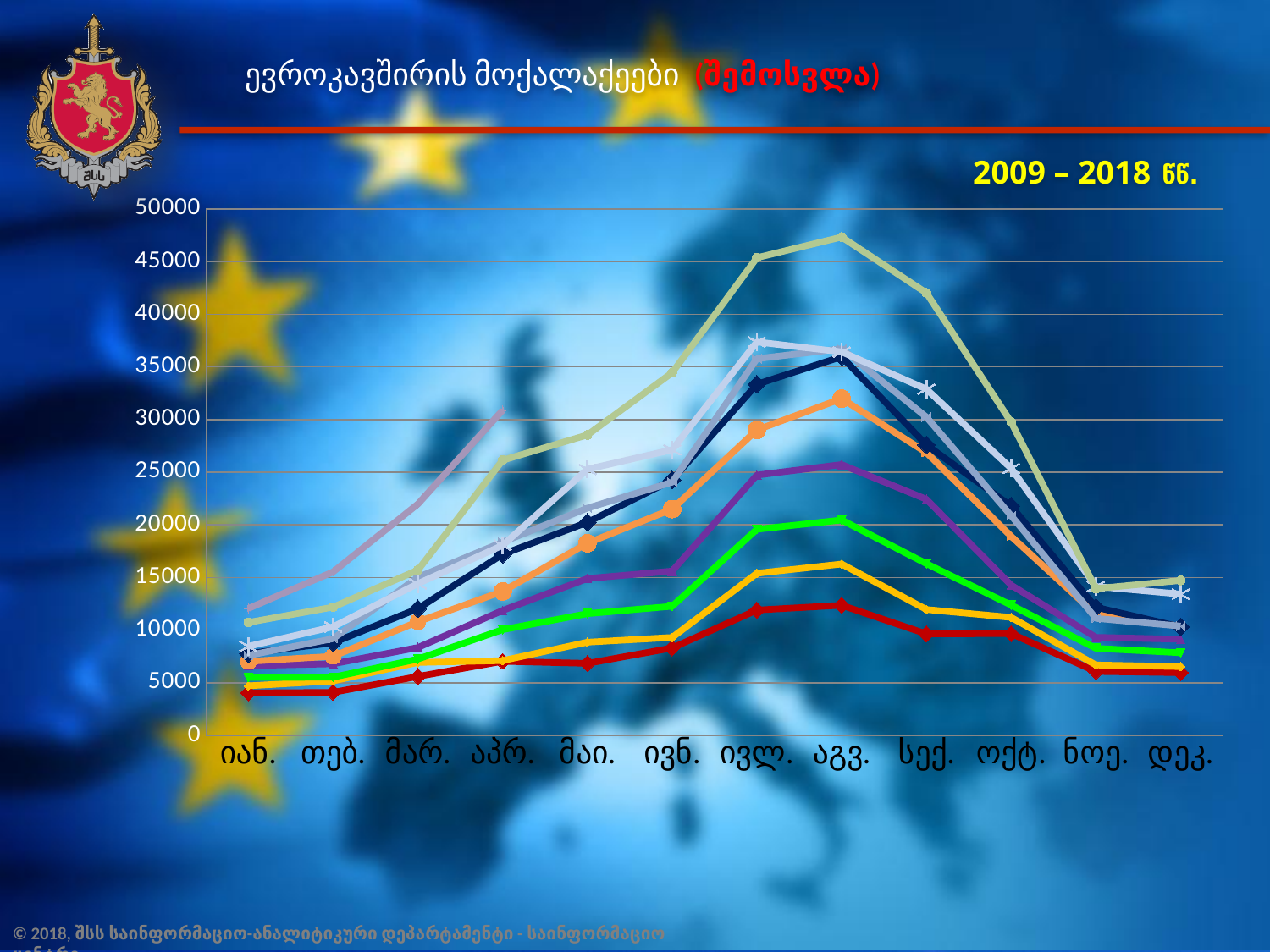
Which years does the chart cover, according to the label above it? 2009 – 2018 In which month does the topmost (pale yellow-green) line reach its highest value? აგვ. In აგვ., which line has the larger value: the red line or the pale yellow-green line? the pale yellow-green line What kind of chart is shown on the slide? line chart Is the value of the pale yellow-green line in აგვ. greater or less than 45000? greater How many months are shown along the x axis of the chart? 12 Is the value of the purple line in აგვ. greater or less than 20000? greater Does the pale yellow-green line rise or fall from აგვ. to ნოე.? fall Is the value of the orange line with circle markers in აგვ. greater or less than 30000? greater What is the highest value shown on the y axis of the chart? 50000